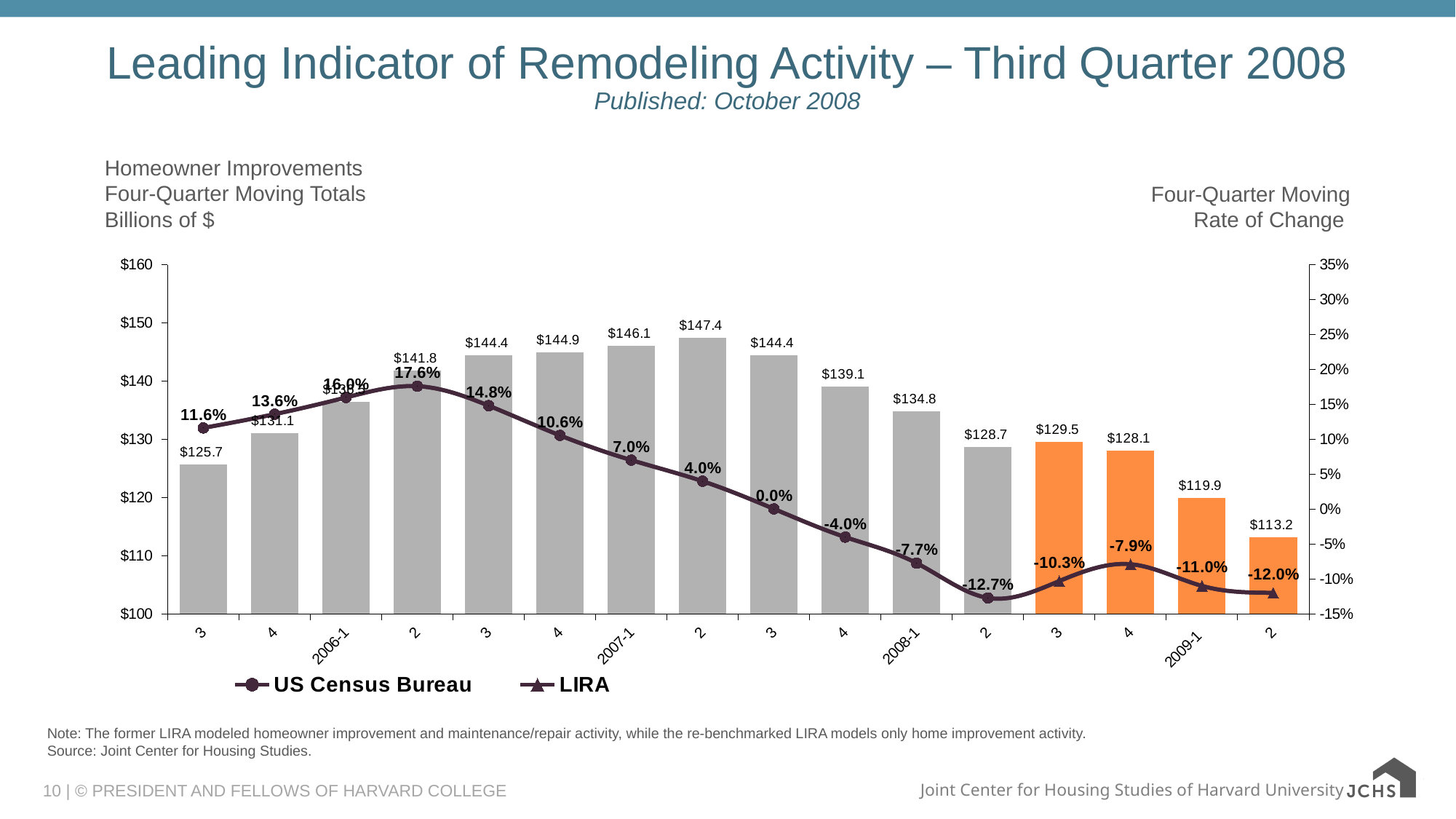
How many series does the legend list? 2 What kind of chart is shown on the slide? A bar chart combined with a line chart What is the highest four-quarter moving rate of change shown on the line, and in which quarter? 17.6% in 2006-2 What is the four-quarter moving total for 2007-2? $147.4 What is the four-quarter moving rate of change shown for 2008-2? -12.7% How many quarters are plotted along the x axis? 16 Which is larger, the four-quarter moving total for 2008-3 or for 2008-4? 2008-3 ($129.5) What is the difference between the four-quarter moving totals for 2008-1 and 2008-2? $6.1 Is the four-quarter moving total bar for 2006-1 greater or less than $140? less Does the four-quarter moving rate of change line rise or fall from 2006-2 to 2008-2? fall Which quarter has the highest four-quarter moving total bar? 2007-2 Which quarter has the lowest four-quarter moving total bar? 2009-2